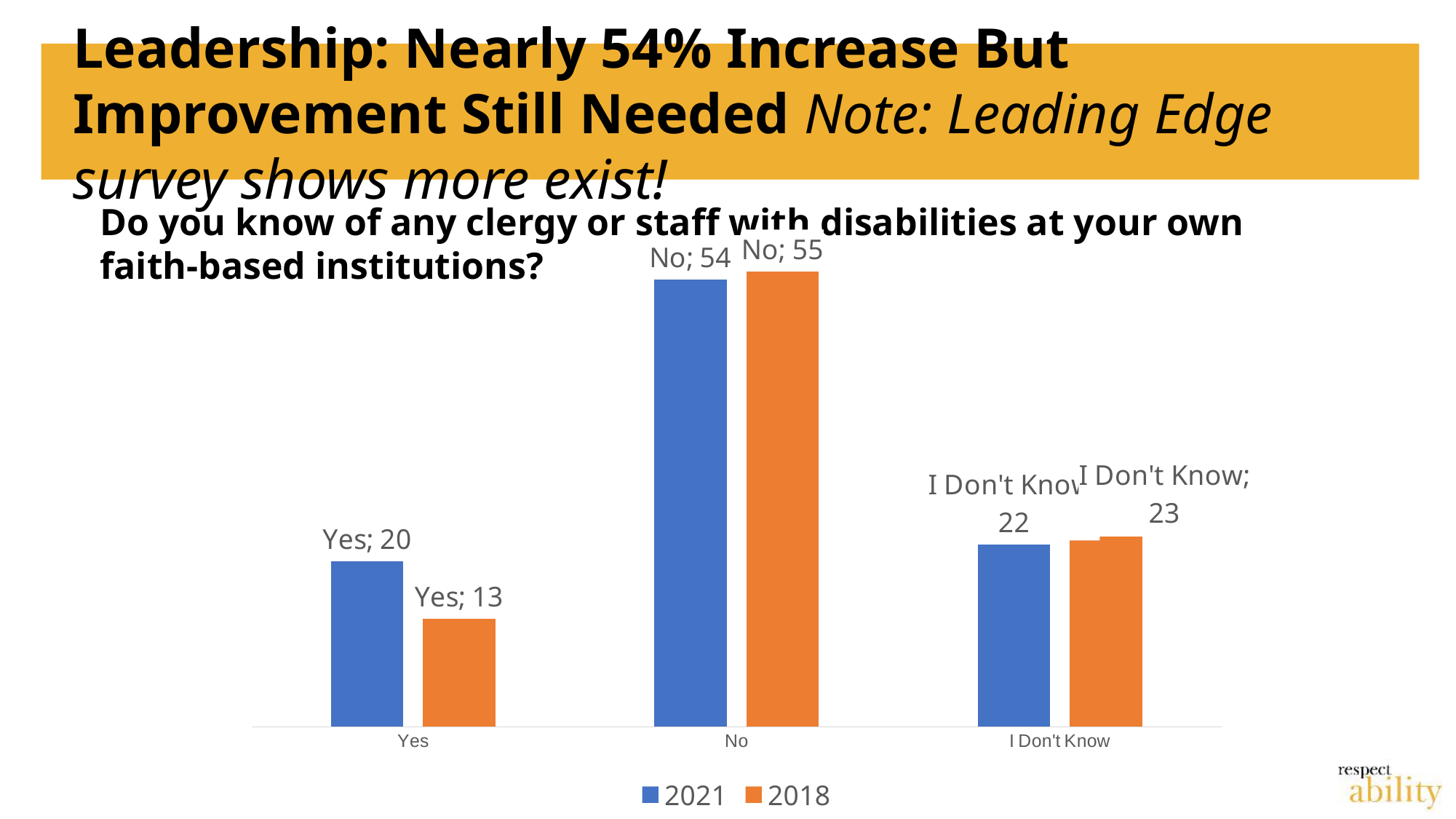
What is the value for "No" in the 2021 series? 54 How many series does the legend list? 2 What is the value for "Yes" in the 2018 series? 13 Which category has the highest value in the 2021 series? No What kind of chart is shown on the slide? Bar chart Which series is shown in orange? 2018 Which is larger for "Yes": the 2021 value or the 2018 value? 2021 Which category has the lowest value in the 2018 series? Yes What is the value for "Yes" in the 2021 series? 20 What is the difference between the 2021 and 2018 values for "Yes"? 7 What is the value for "I Don't Know" in the 2018 series? 23 How many categories are shown on the x axis? 3